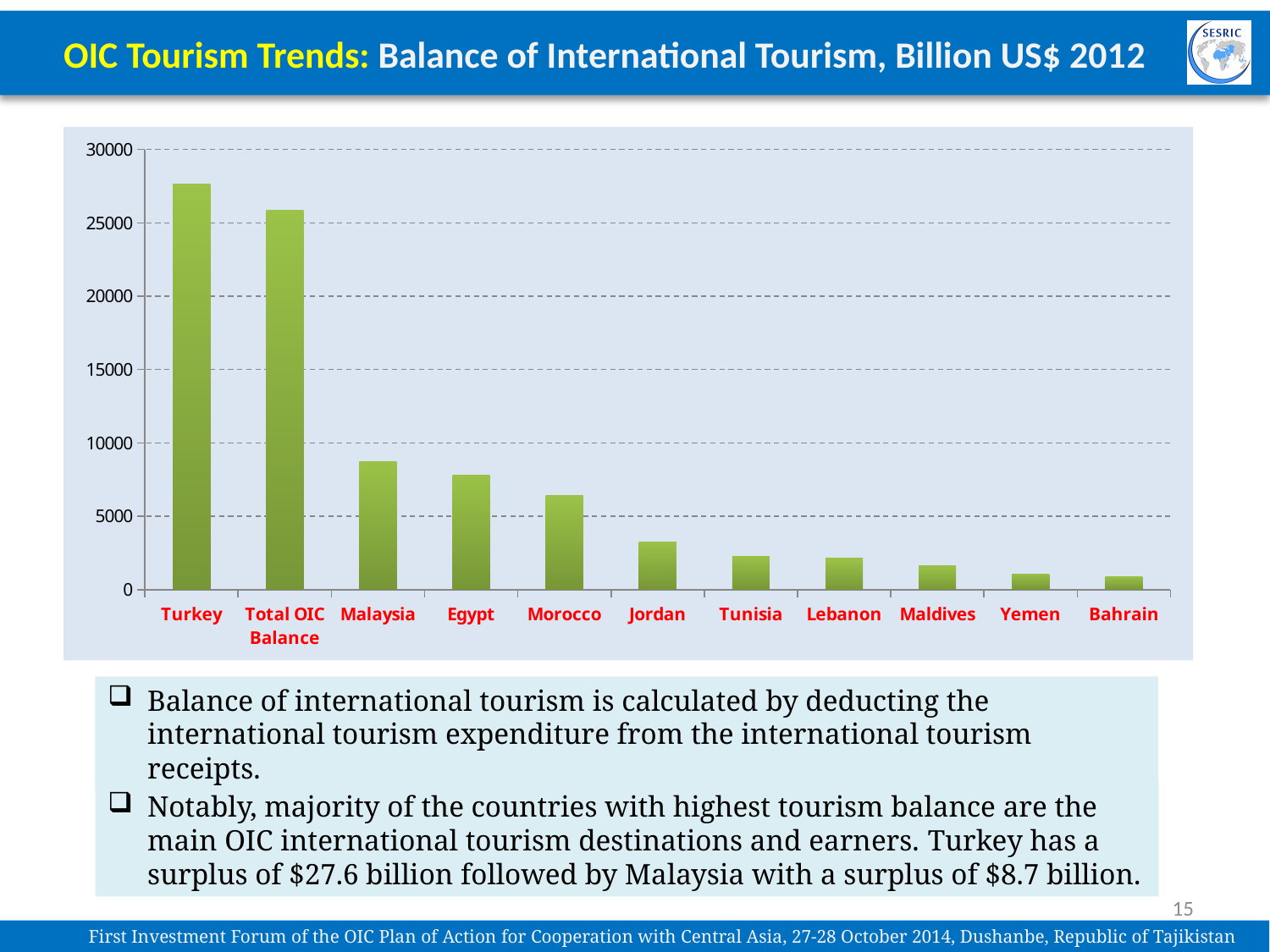
Is the value for Egypt greater or less than 5000? greater Which has the larger value, Malaysia or Egypt? Malaysia Which category has the highest bar in the chart? Turkey What colour are the bars in the chart? Green What kind of chart is shown on the slide? Bar chart Is the value for Turkey greater or less than 25000? greater Which category has the lowest bar in the chart? Bahrain Do the bar values rise or fall moving from left to right along the x axis? Fall Is the value for Jordan greater or less than 5000? less How many categories are shown on the x axis of the chart? 11 Which has the larger value, Jordan or Tunisia? Jordan